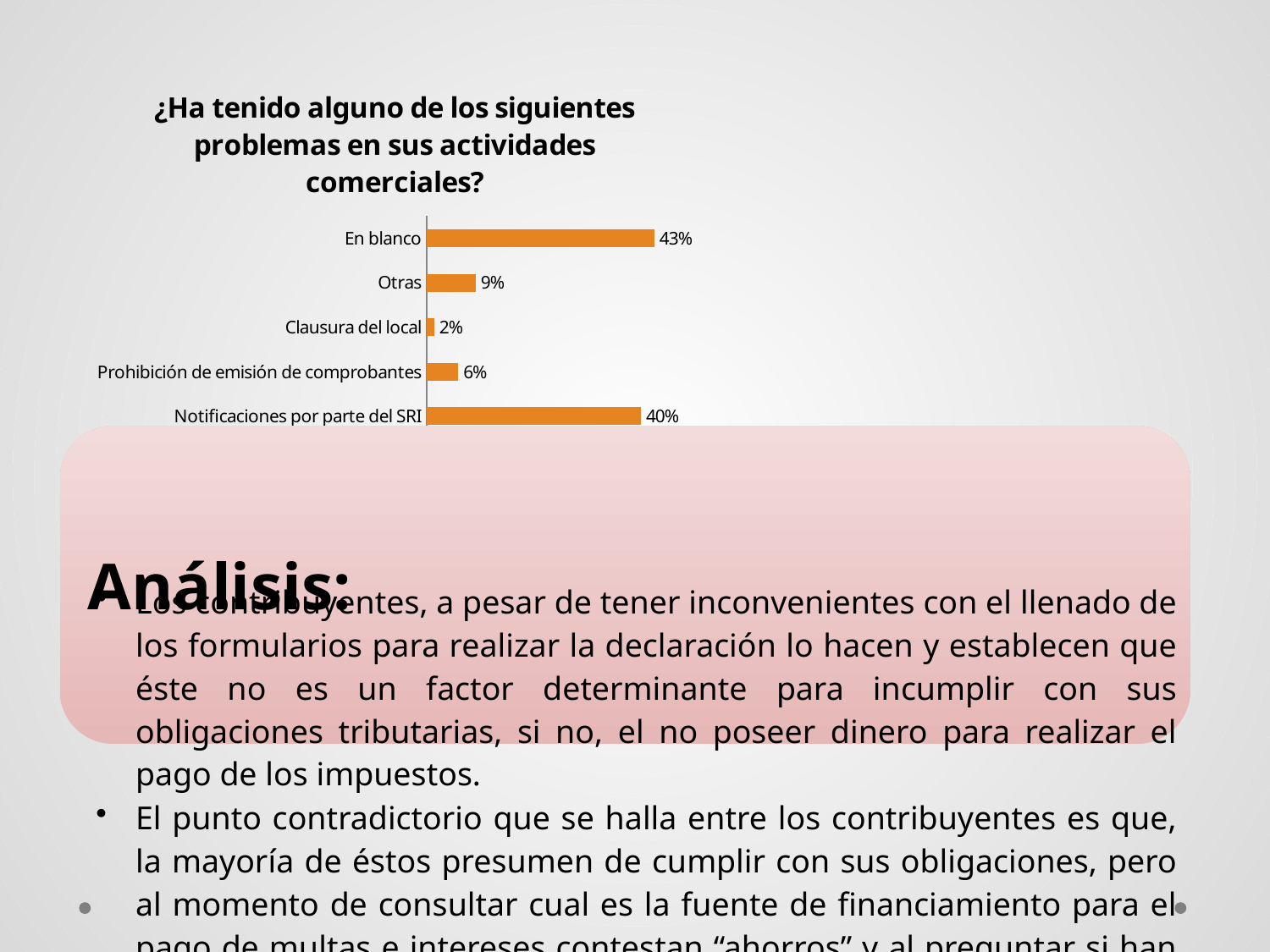
Which category has the lowest value? Clausura del local What is the value for 'En blanco'? 43% Which is larger, the value for 'Otras' or the value for 'Prohibición de emisión de comprobantes'? Otras What is the difference between the values for 'En blanco' and 'Notificaciones por parte del SRI'? 3% What is the value for 'Notificaciones por parte del SRI'? 40% Which category has the highest value? En blanco What kind of chart is shown on the slide? Bar chart How many categories are shown in the chart? 5 What is the value for 'Prohibición de emisión de comprobantes'? 6% What is the value for 'Otras'? 9% What is the value for 'Clausura del local'? 2% What is the title of the chart? ¿Ha tenido alguno de los siguientes problemas en sus actividades comerciales?